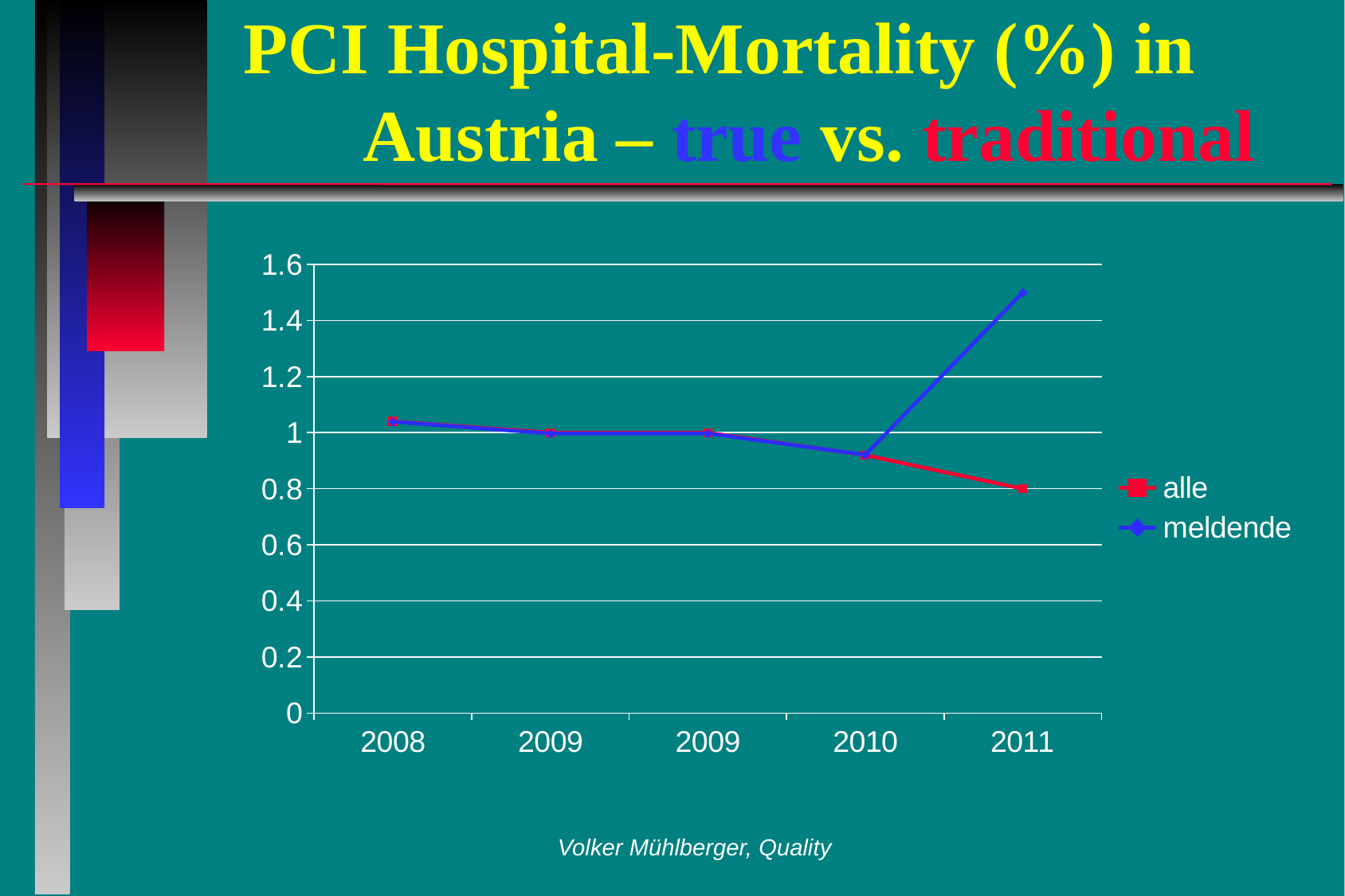
What are the two legend entries? alle, meldende Do the values for 'alle' rise or fall from 2008 to 2011? fall In which year does the 'meldende' series reach its highest value? 2011 How many series does the legend list? 2 Is the value for 'alle' in 2011 greater or less than 1? less Is the value for 'alle' in 2008 greater or less than 0.8? greater In 2011, which series has the larger value, 'alle' or 'meldende'? meldende In which year does the 'alle' series reach its lowest value? 2011 How many points are plotted along the x axis for each series? 5 Is the value for 'meldende' in 2011 greater or less than 1.4? greater What kind of chart is shown on the slide? line chart Which series is drawn in blue? meldende